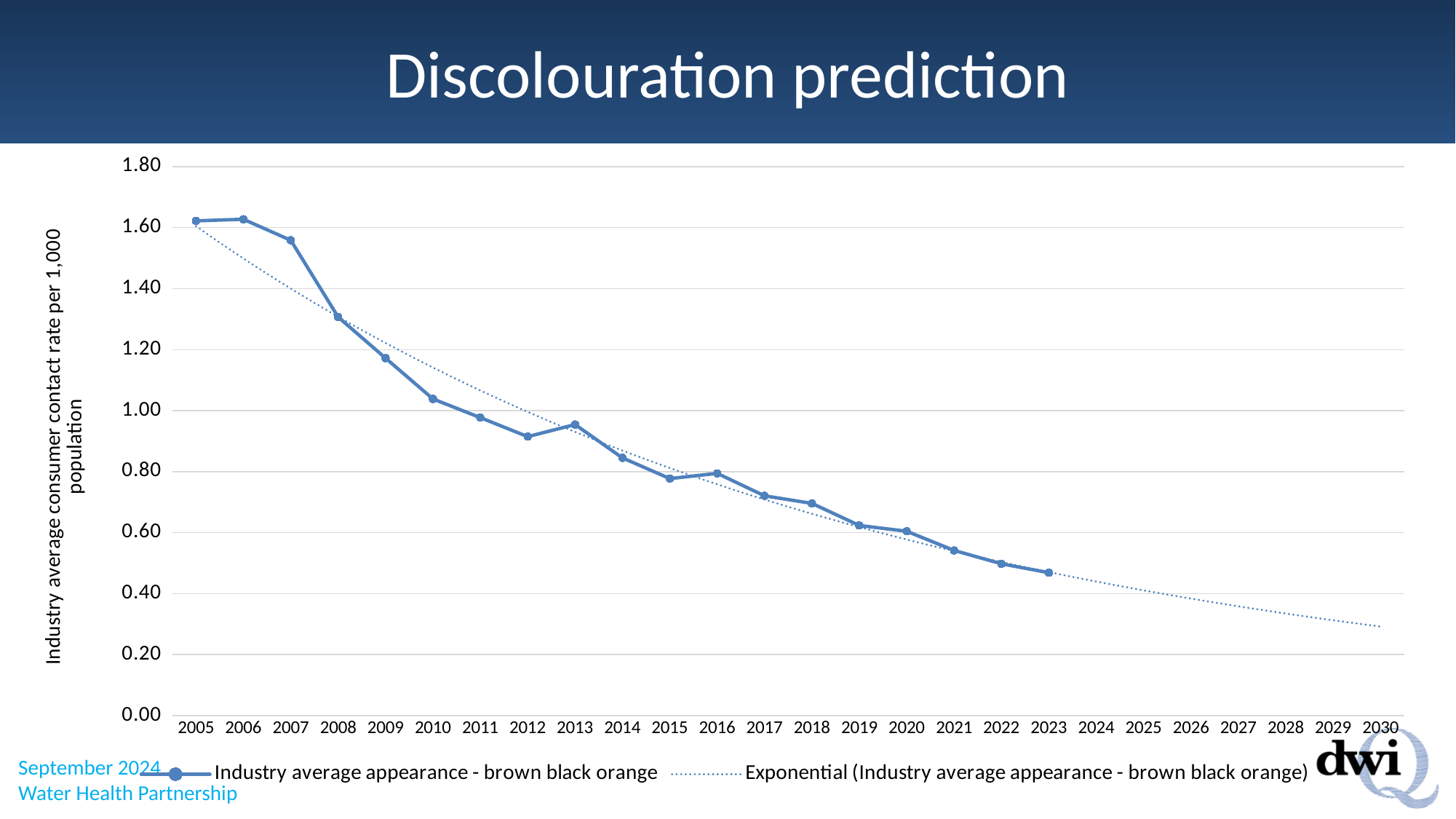
What is the title of the chart on the slide? Discolouration prediction What kind of chart is shown on the slide? line chart Is the value for 2008 greater or less than 1.40? less Is the value for 2023 greater or less than 0.40? greater Is the value for 2008 greater or less than 1.20? greater Do the plotted values generally rise or fall from 2005 to 2023? fall How many series does the legend list? 2 Which year has the lowest plotted value on the solid line? 2023 How many plotted data points does the solid 'Industry average appearance - brown black orange' line have? 19 Which year has the larger value, 2007 or 2008? 2007